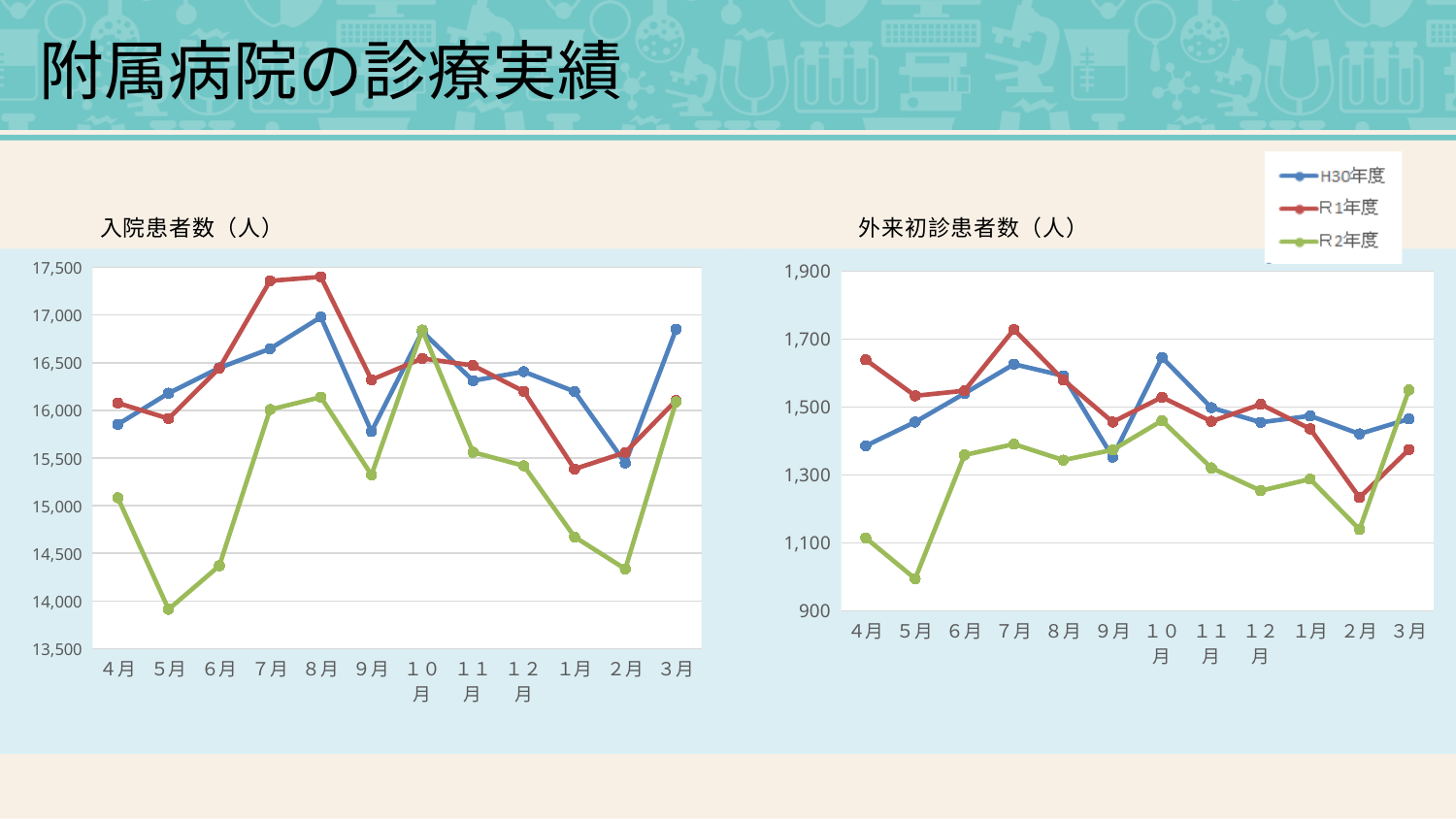
What kind of chart is the 入院患者数（人） chart on the left? line chart In the 入院患者数（人） chart on the left, which is larger in 7月, the R1年度 value or the H30年度 value? R1年度 In the 入院患者数（人） chart on the left, is the R2年度 value for 5月 greater or less than 14,000? less How many months are plotted along the x axis of the 外来初診患者数（人） chart on the right? 12 In the 入院患者数（人） chart on the left, is the R1年度 value for 8月 greater or less than 17,000? greater In the 外来初診患者数（人） chart on the right, which month has the lowest R1年度 value? 2月 In the 外来初診患者数（人） chart on the right, which month has the highest R1年度 value? 7月 Which colour is used for the R2年度 series in the legend? green In the 外来初診患者数（人） chart on the right, is the R2年度 value for 5月 greater or less than 1,100? less How many series does the legend list for the charts on the slide? 3 In the 外来初診患者数（人） chart on the right, which is larger in 4月, the R1年度 value or the H30年度 value? R1年度 In the 入院患者数（人） chart on the left, which month has the lowest R2年度 value? 5月